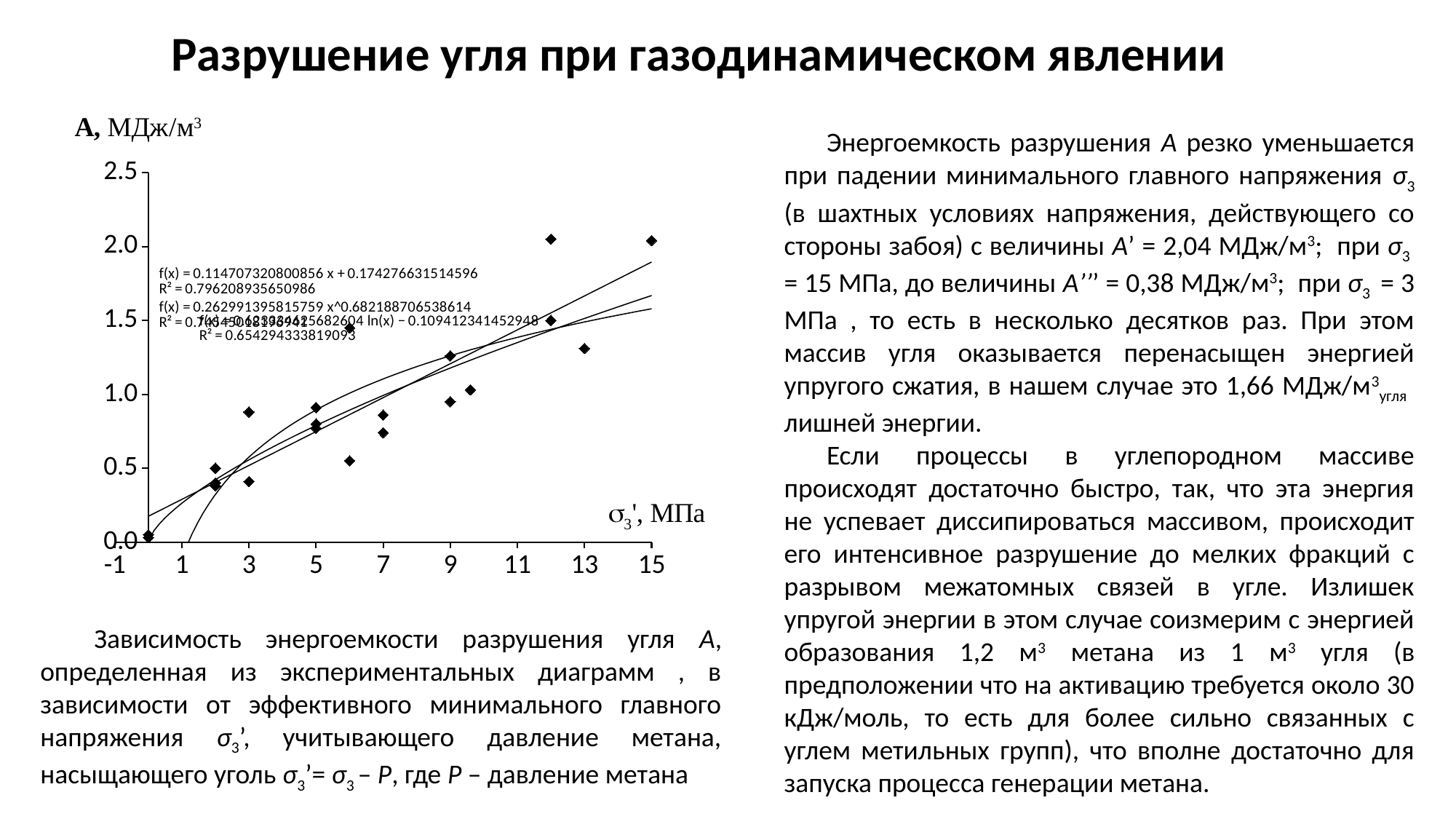
Overall, do the plotted values of A rise or fall as σ3' increases along the x axis? rise Is the lowest plotted point at σ3' = 3 MPa greater or less than 0.5? less Is the highest plotted point at σ3' = 12 MPa greater or less than 1.5? greater Is the value of A at σ3' = 13 MPa greater or less than 1.0? greater Which has the larger value of A: the point at σ3' = 15 MPa or the point at σ3' = 13 MPa? σ3' = 15 MPa What is the R² value printed for the linear trendline f(x) = 0.114707320800856 x + 0.174276631514596? 0.796208935650986 What kind of chart is shown on the slide? scatter chart What is the highest tick value shown on the vertical axis of the chart? 2.5 Which has the larger value of A: the point at σ3' = 0 MPa or the highest point at σ3' = 2 MPa? σ3' = 2 MPa